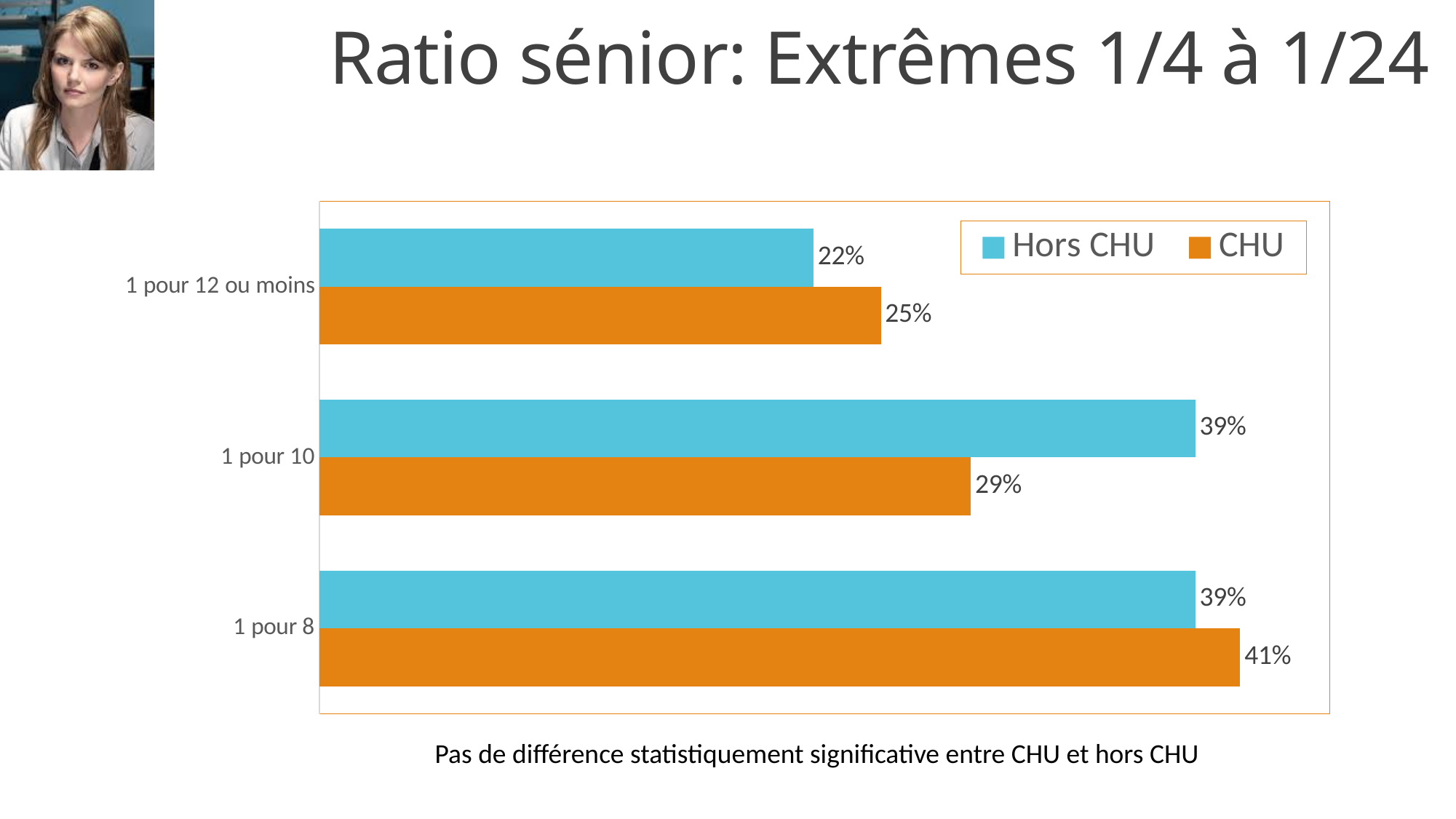
What is the Hors CHU value for '1 pour 12 ou moins'? 22% How many categories are shown on the chart? 3 Which category has the highest CHU value? 1 pour 8 What is the CHU value for '1 pour 12 ou moins'? 25% What is the difference between the Hors CHU and CHU values for '1 pour 10'? 10% For '1 pour 12 ou moins', which series has the larger value, Hors CHU or CHU? CHU How many series does the legend list? 2 Which category has the lowest Hors CHU value? 1 pour 12 ou moins What is the Hors CHU value for '1 pour 10'? 39% What is the CHU value for '1 pour 8'? 41% Which colour represents the CHU series in the legend? Orange What kind of chart is shown on the slide? Bar chart